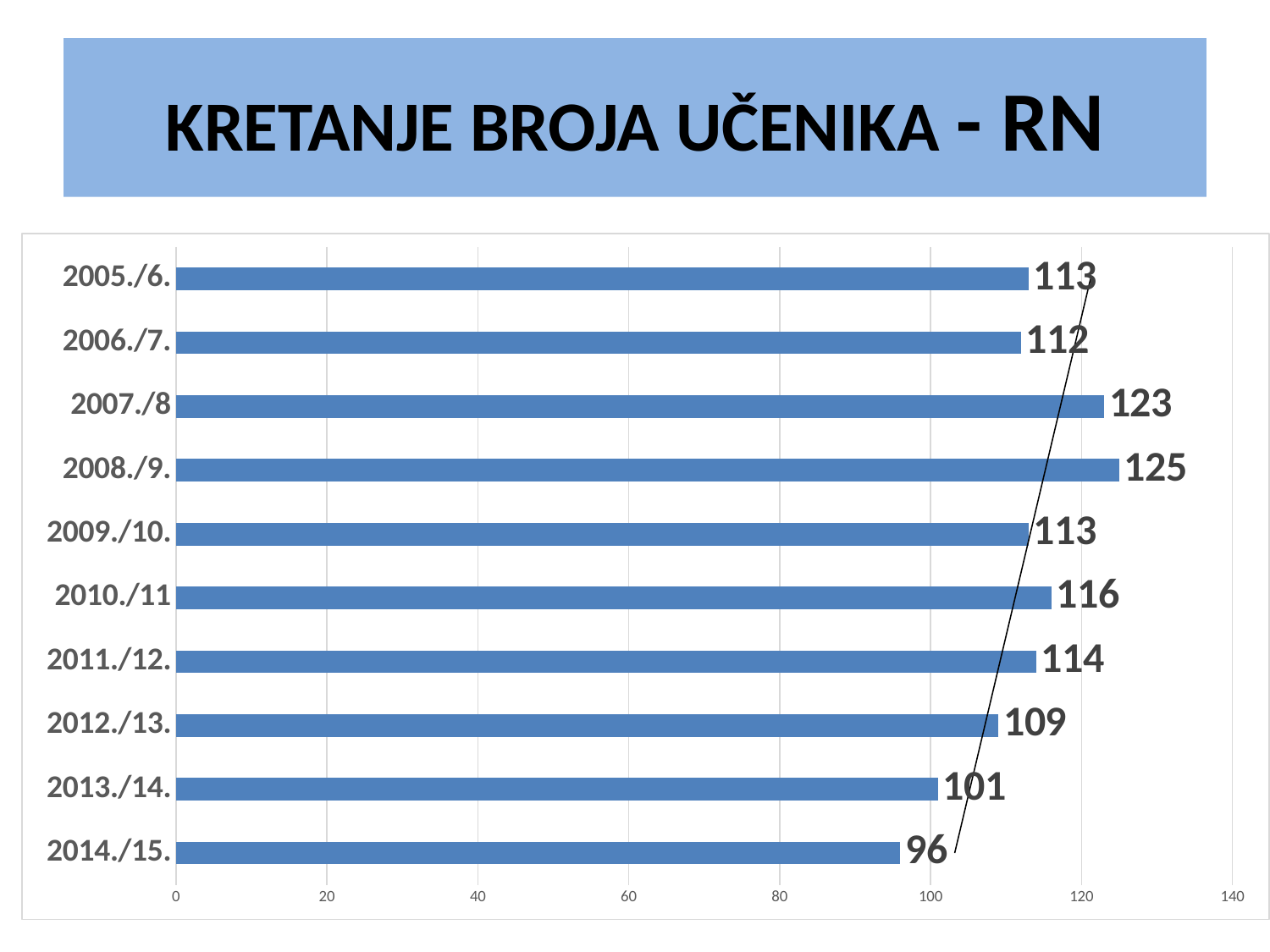
What is the value for 2008./9.? 125 What is the difference between the values for 2007./8 and 2012./13.? 14 Which school year has the highest value? 2008./9. Is the value for 2014./15. greater or less than 100? less What is the title of the slide? KRETANJE BROJA UČENIKA - RN Which is larger, the value for 2010./11 or the value for 2013./14.? 2010./11 What is the difference between the values for 2008./9. and 2014./15.? 29 How many school years are shown in the chart? 10 What is the value for 2014./15.? 96 What is the value for 2011./12.? 114 Which school year has the lowest value? 2014./15. What kind of chart is shown on the slide? bar chart